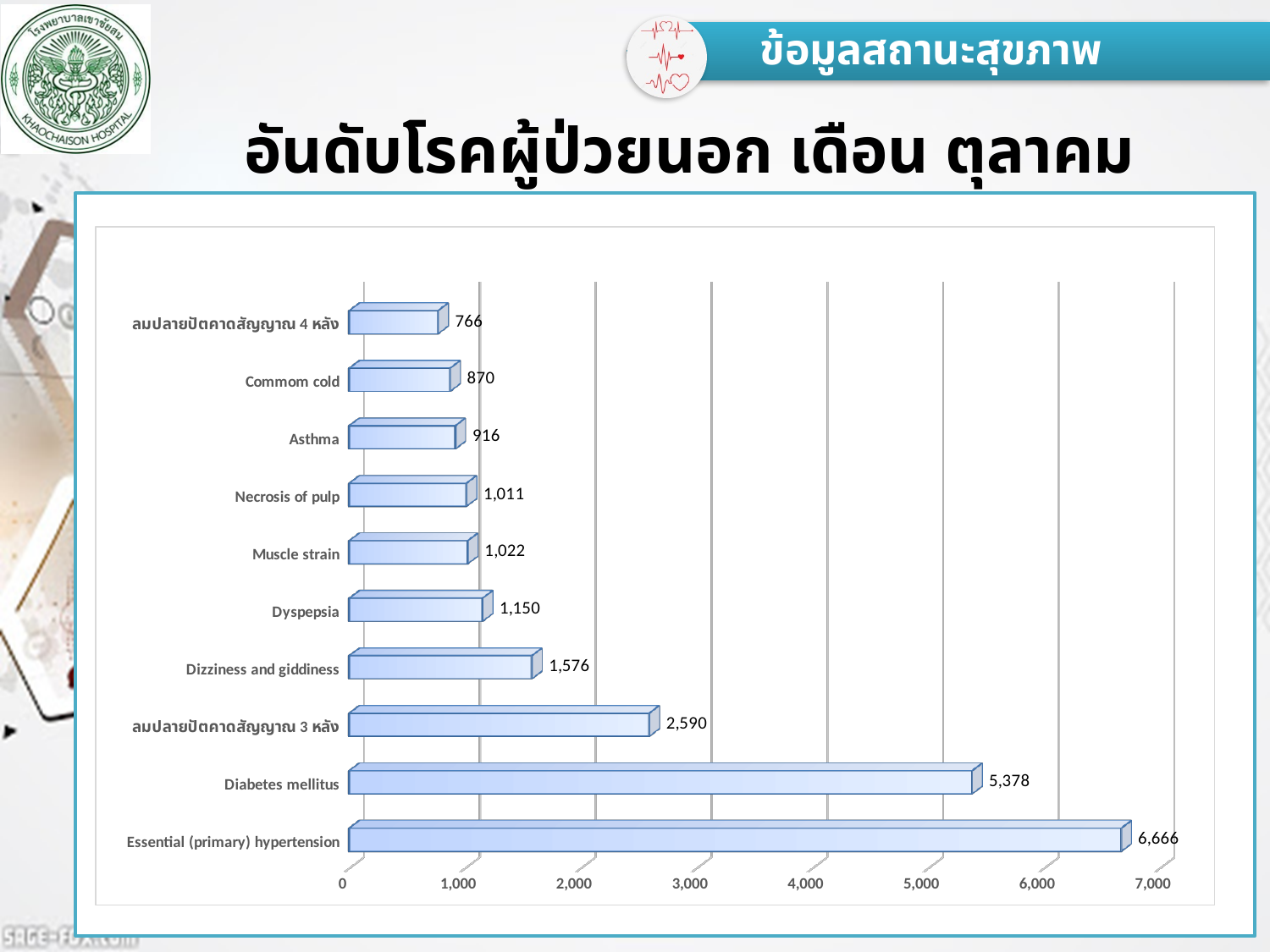
Which is larger, the value for Necrosis of pulp or the value for Asthma? Necrosis of pulp What is the value for Essential (primary) hypertension? 6,666 Which category has the highest value? Essential (primary) hypertension What is the value for Diabetes mellitus? 5,378 How many categories are shown in the chart? 10 What kind of chart is shown on the slide? bar chart Which category has the lowest value? ลมปลายปัตคาดสัญญาณ 4 หลัง What is the value for Asthma? 916 Is the value for ลมปลายปัตคาดสัญญาณ 3 หลัง greater or less than 2,000? greater What is the difference between the values for Dyspepsia and Commom cold? 280 What is the difference between the values for Essential (primary) hypertension and Diabetes mellitus? 1,288 What is the value for Dizziness and giddiness? 1,576